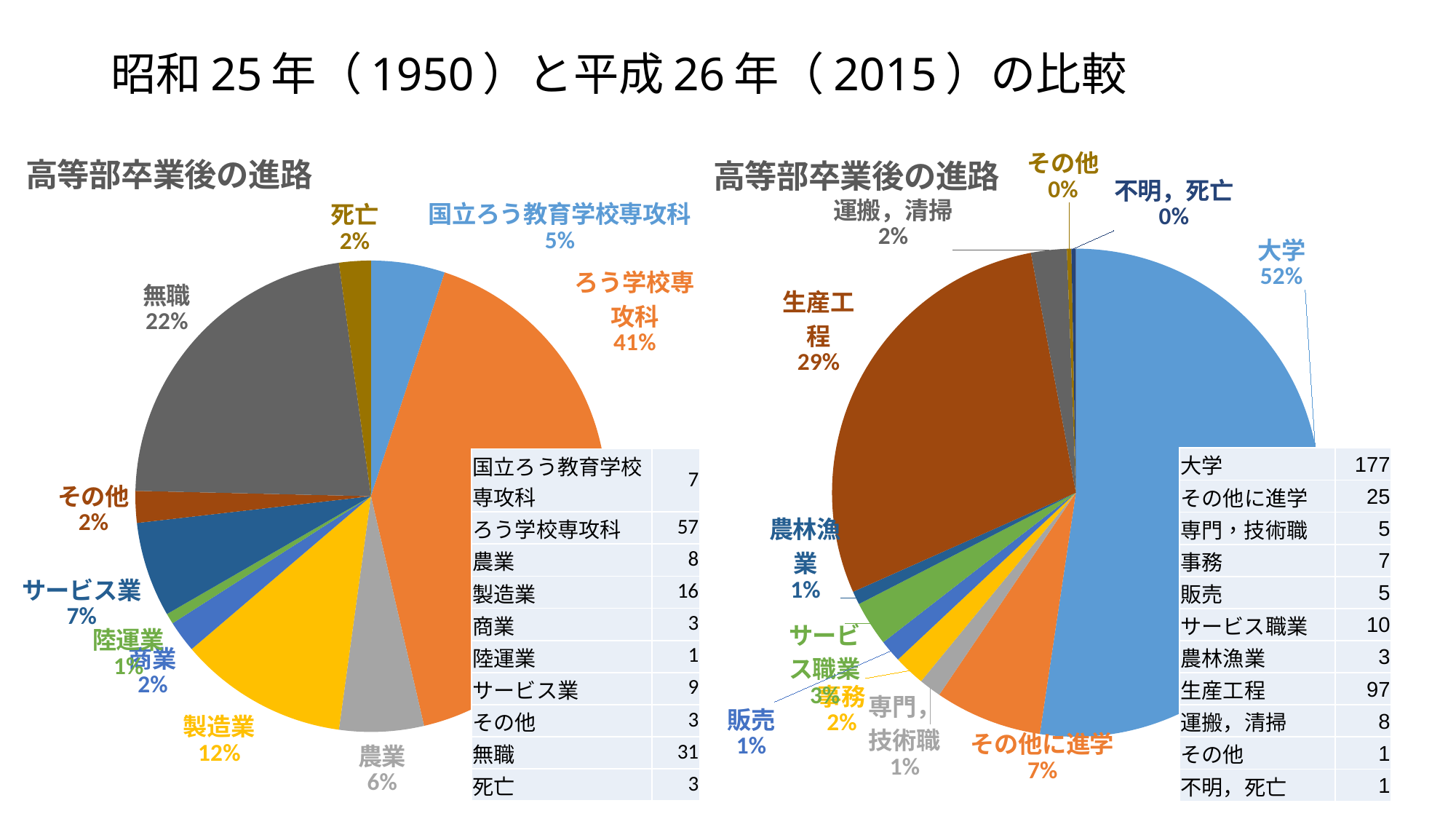
What is the title of the left pie chart? 高等部卒業後の進路 In the left pie chart, what share does ろう学校専攻科 have? 41% In the left pie chart, what share does 無職 have? 22% In the right pie chart, which is larger, その他に進学 or サービス職業? その他に進学 In the left pie chart, which category has the largest share? ろう学校専攻科 In the left pie chart, what is the difference in percentage points between 製造業 and 農業? 6 In the right pie chart, what is the difference in percentage points between 大学 and 生産工程? 23 How many categories does the right pie chart show? 11 What kind of chart is used on the left side of the slide? pie chart In the right pie chart, which category has the largest share? 大学 In the right pie chart, what share does 大学 have? 52%